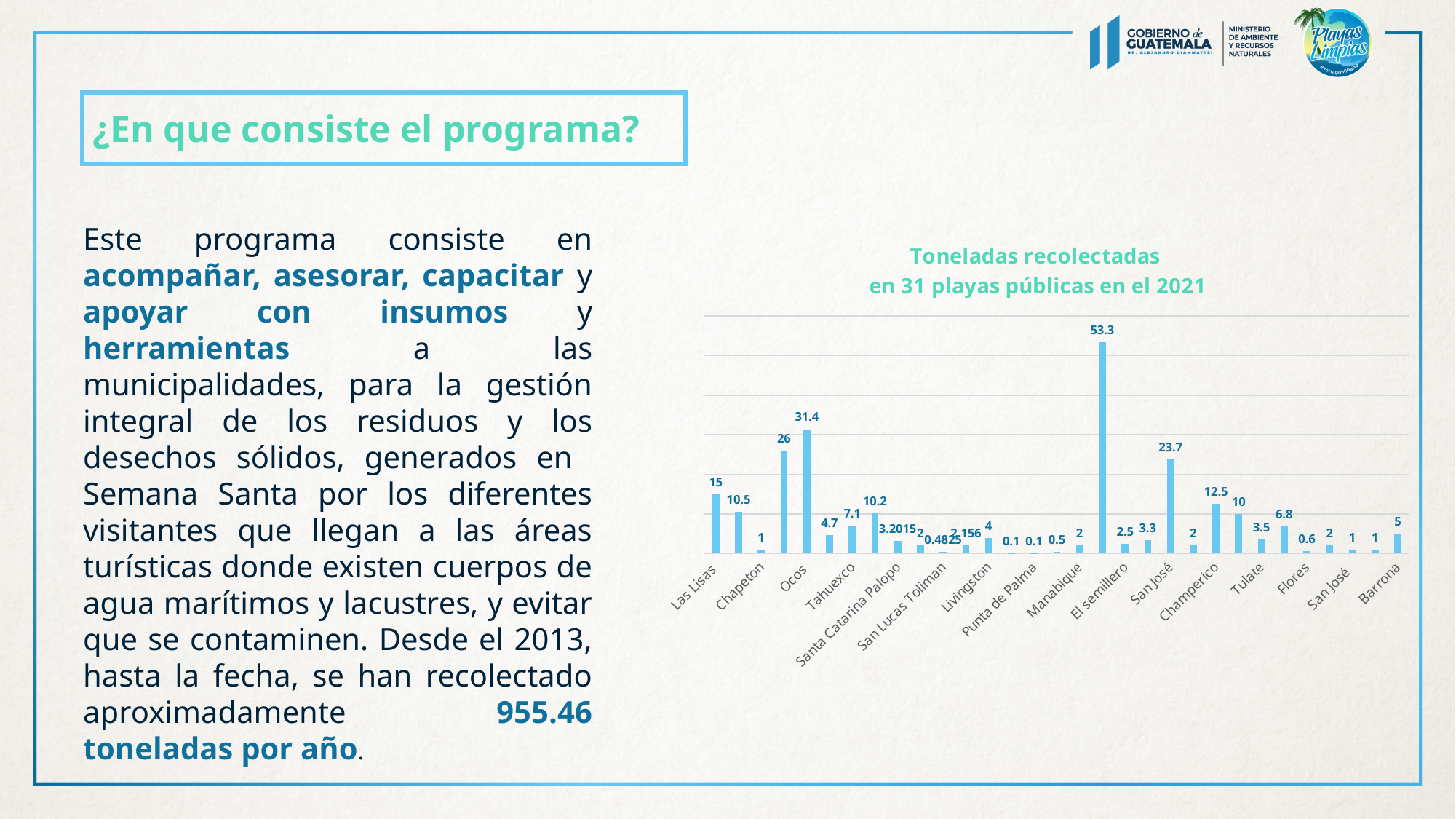
What is the highest value shown in the chart? 53.3 What is the difference between the values for Las Lisas and Barrona? 10 What is the value for Barrona? 5 What is the value for Las Lisas? 15 What is the value for Ocos? 31.4 What kind of chart is shown on the slide? bar chart Which has a larger value, Champerico or Tahuexco? Champerico What is the title of the chart? Toneladas recolectadas en 31 playas públicas en el 2021 How many bars (beaches) are plotted in the chart? 31 What is the value for Champerico? 12.5 What is the value for Tahuexco? 7.1 Which has a larger value, Ocos or Las Lisas? Ocos